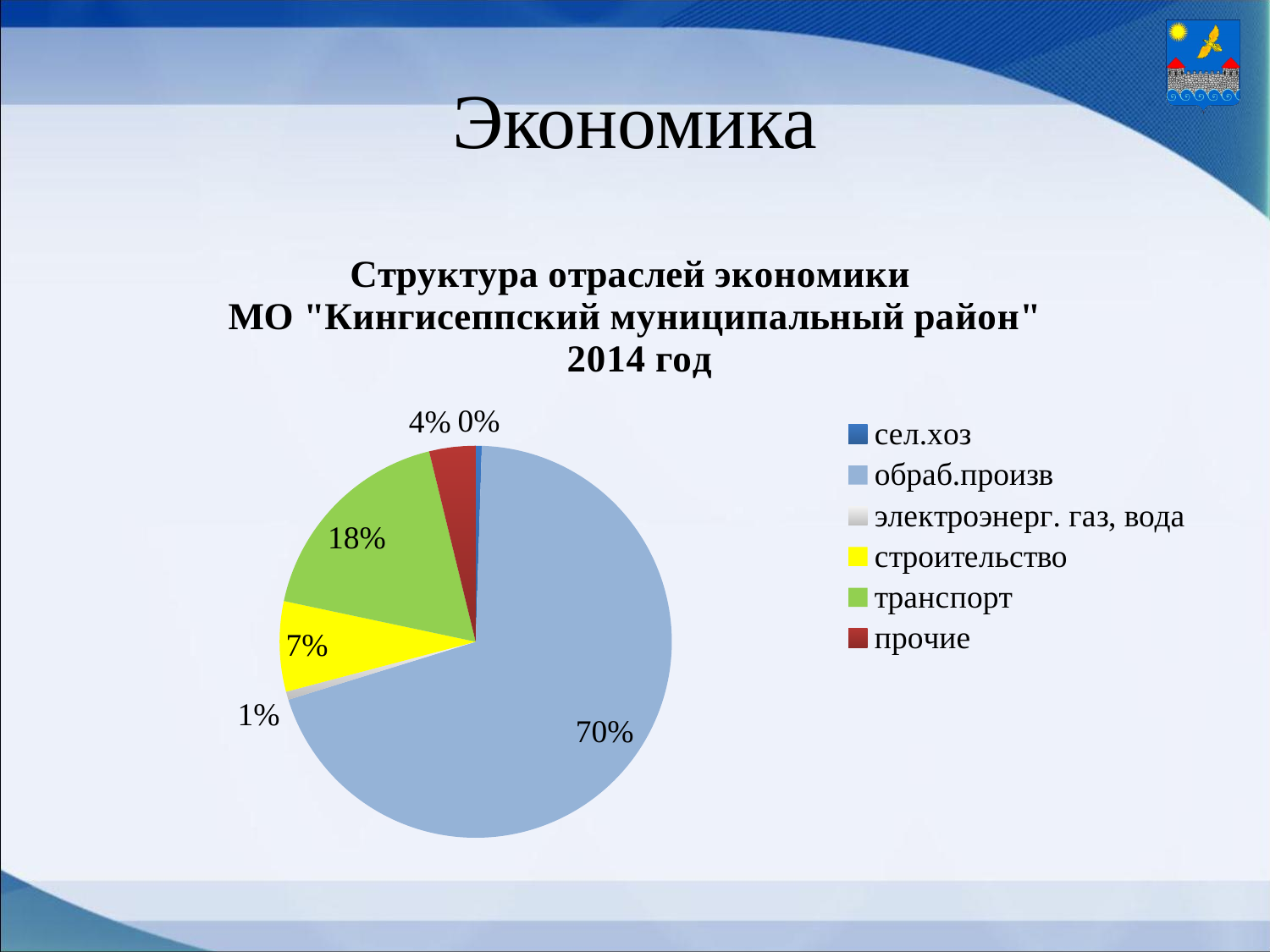
What share of the pie does электроэнерг. газ, вода have? 1% What share of the pie does обраб.произв have? 70% Which has a larger share, строительство or прочие? строительство What share of the pie does транспорт have? 18% What is the difference between the shares of обраб.произв and транспорт? 52% Which category has the smallest share of the pie? сел.хоз What share of the pie does строительство have? 7% What share of the pie does сел.хоз have? 0% What kind of chart is shown on the slide? pie chart Which category has the largest share of the pie? обраб.произв What share of the pie does прочие have? 4% How many categories does the legend list? 6